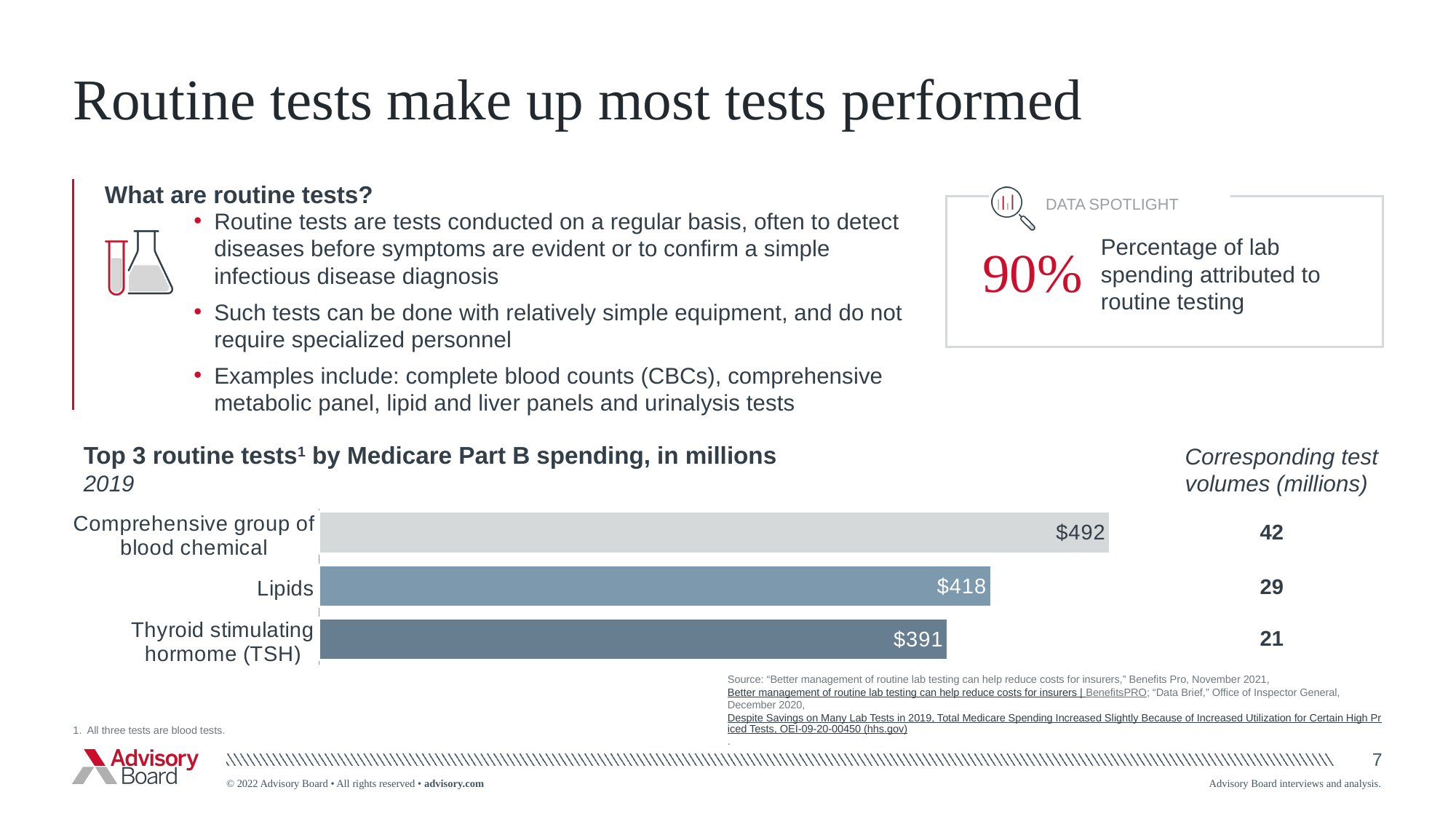
Which routine test has the lowest Medicare Part B spending in the chart? Thyroid stimulating hormone (TSH) Which routine test has the highest Medicare Part B spending in the chart? Comprehensive group of blood chemical What is the Medicare Part B spending value shown for Lipids? $418 What is the difference in spending between Comprehensive group of blood chemical and Lipids? $74 Which has higher Medicare Part B spending, Lipids or Thyroid stimulating hormone (TSH)? Lipids What is the Medicare Part B spending value shown for Comprehensive group of blood chemical? $492 How many routine tests are shown in the bar chart? 3 What is the Medicare Part B spending value shown for Thyroid stimulating hormone (TSH)? $391 What kind of chart is used to show the top 3 routine tests by Medicare Part B spending? Bar chart What is the difference in spending between Lipids and Thyroid stimulating hormone (TSH)? $27 What is the corresponding test volume (millions) listed for Lipids? 29 What year does the chart of top 3 routine tests by Medicare Part B spending cover? 2019